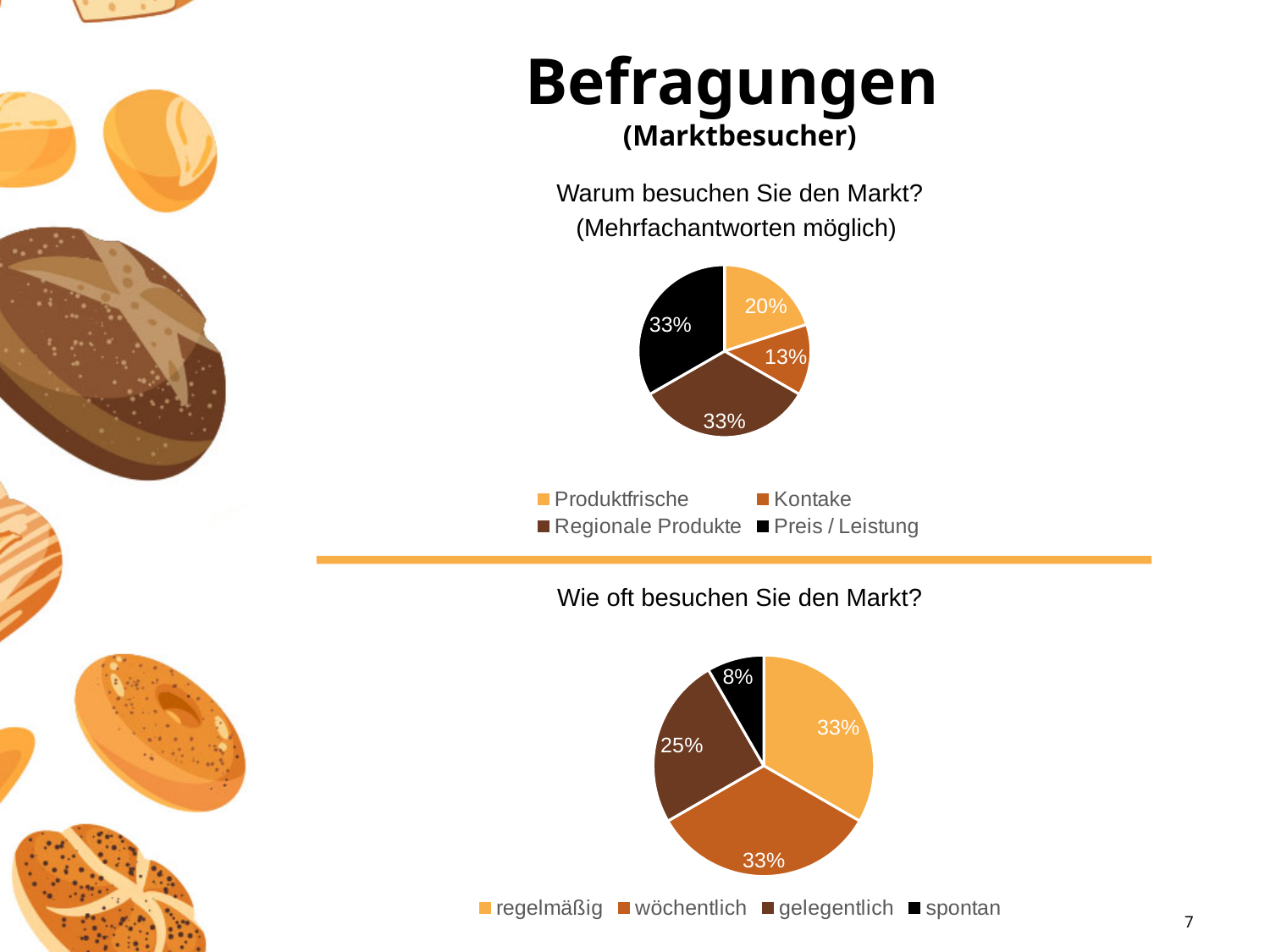
In the chart 'Wie oft besuchen Sie den Markt?', which colour represents spontan? Black In the chart 'Warum besuchen Sie den Markt?', what is the difference between the Produktfrische and Kontake shares? 7% In the chart 'Wie oft besuchen Sie den Markt?', what share is labelled for gelegentlich? 25% What kind of chart is used for 'Wie oft besuchen Sie den Markt?'? Pie chart How many categories does the legend of the chart 'Warum besuchen Sie den Markt?' list? 4 In the chart 'Warum besuchen Sie den Markt?', which category has the smallest slice? Kontake In the chart 'Warum besuchen Sie den Markt?', what share is labelled for Produktfrische? 20% In the chart 'Warum besuchen Sie den Markt?', which is larger, Regionale Produkte or Produktfrische? Regionale Produkte In the chart 'Warum besuchen Sie den Markt?', what share is labelled for Kontake? 13% In the chart 'Wie oft besuchen Sie den Markt?', which category has the smallest slice? spontan In the chart 'Wie oft besuchen Sie den Markt?', what is the difference between the gelegentlich and spontan shares? 17% In the chart 'Wie oft besuchen Sie den Markt?', what share is labelled for spontan? 8%